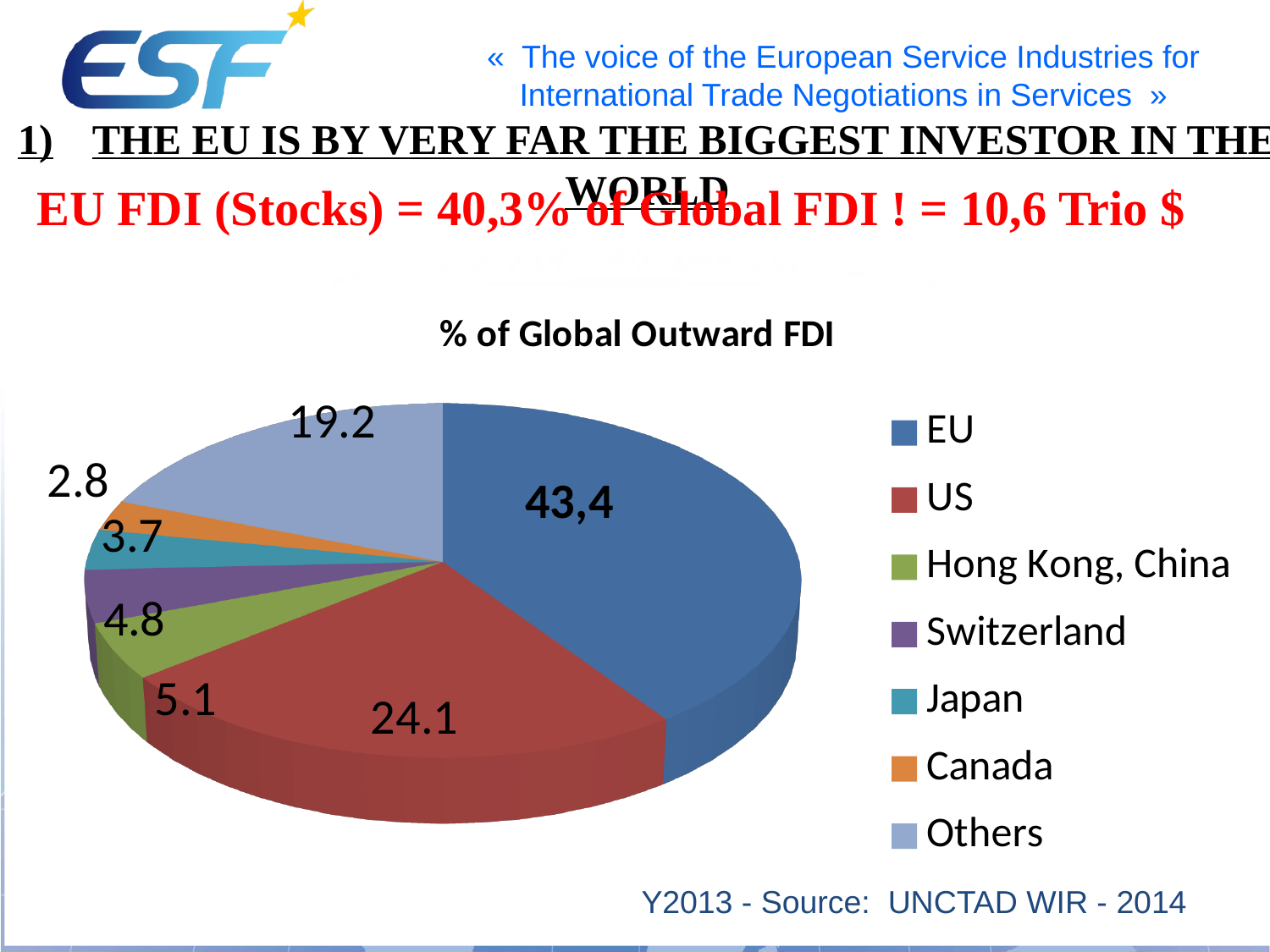
What value is shown for Japan? 3.7 What is the difference between the values for US and Hong Kong, China? 19.0 Which category has the largest slice of the pie? EU What is the title of the chart? % of Global Outward FDI What value is shown for the EU slice? 43,4 Which is larger, the slice for Switzerland or the slice for Japan? Switzerland What value is shown for Hong Kong, China? 5.1 What type of chart is shown on the slide? pie chart How many categories does the pie chart have? 7 What value is shown for the US slice? 24.1 Which category has the smallest slice of the pie? Canada What is the difference between the values for Others and Canada? 16.4